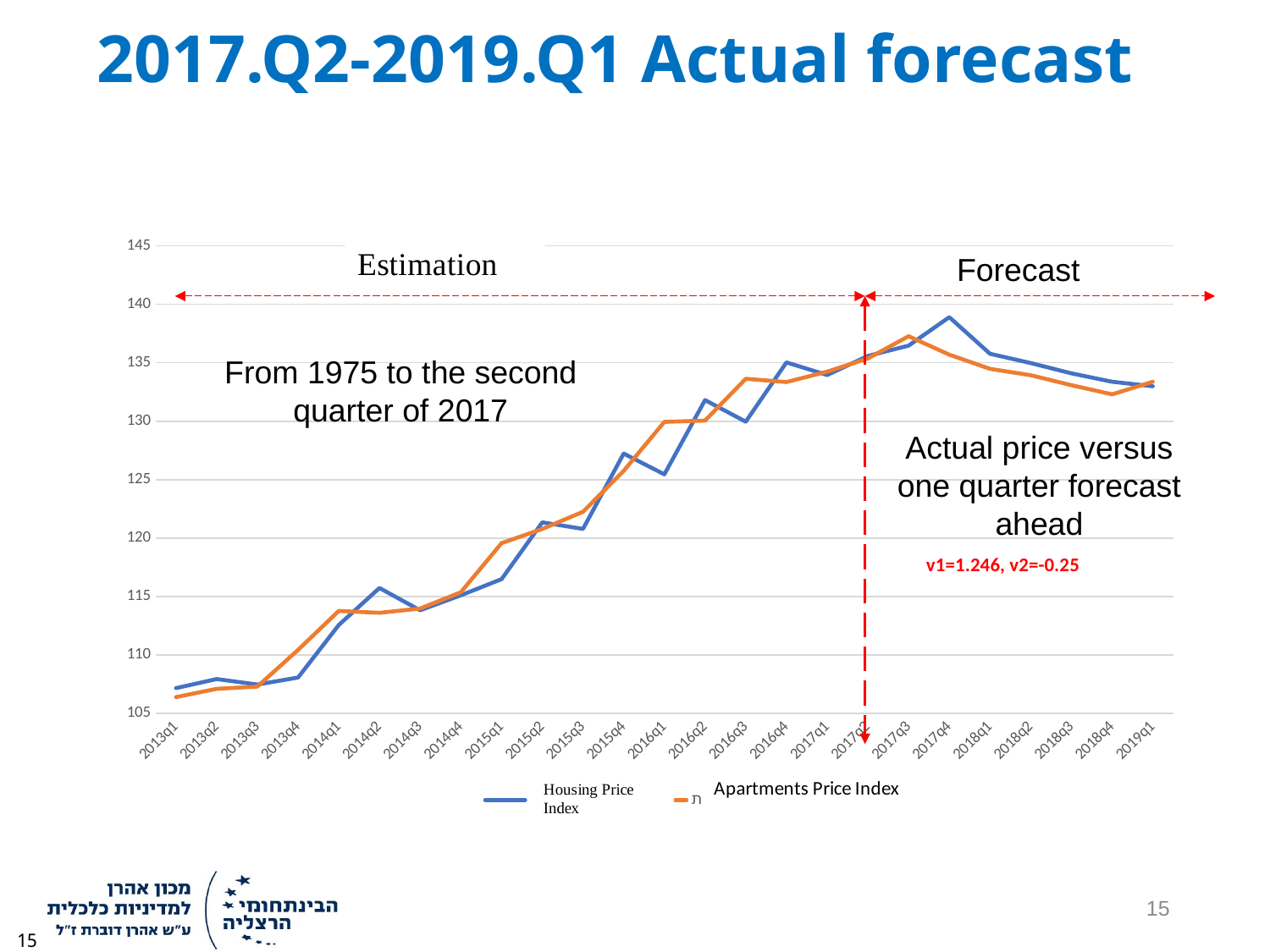
What are the two labelled periods separated by the red dashed vertical line? Estimation and Forecast What kind of chart is shown on the slide? line chart Is the Housing Price Index value for 2017q4 greater or less than 135? greater Is the Housing Price Index value for 2013q1 greater or less than 110? less Is the Apartments Price Index value for 2014q1 greater or less than 110? greater In which quarter does the Housing Price Index reach its highest value? 2017q4 In which quarter is the Housing Price Index at its lowest value? 2013q1 How many quarters are shown along the x axis? 25 At 2016q1, which series has the higher value, Housing Price Index or Apartments Price Index? Apartments Price Index Which series is drawn in orange? Apartments Price Index How many series does the legend list? 2